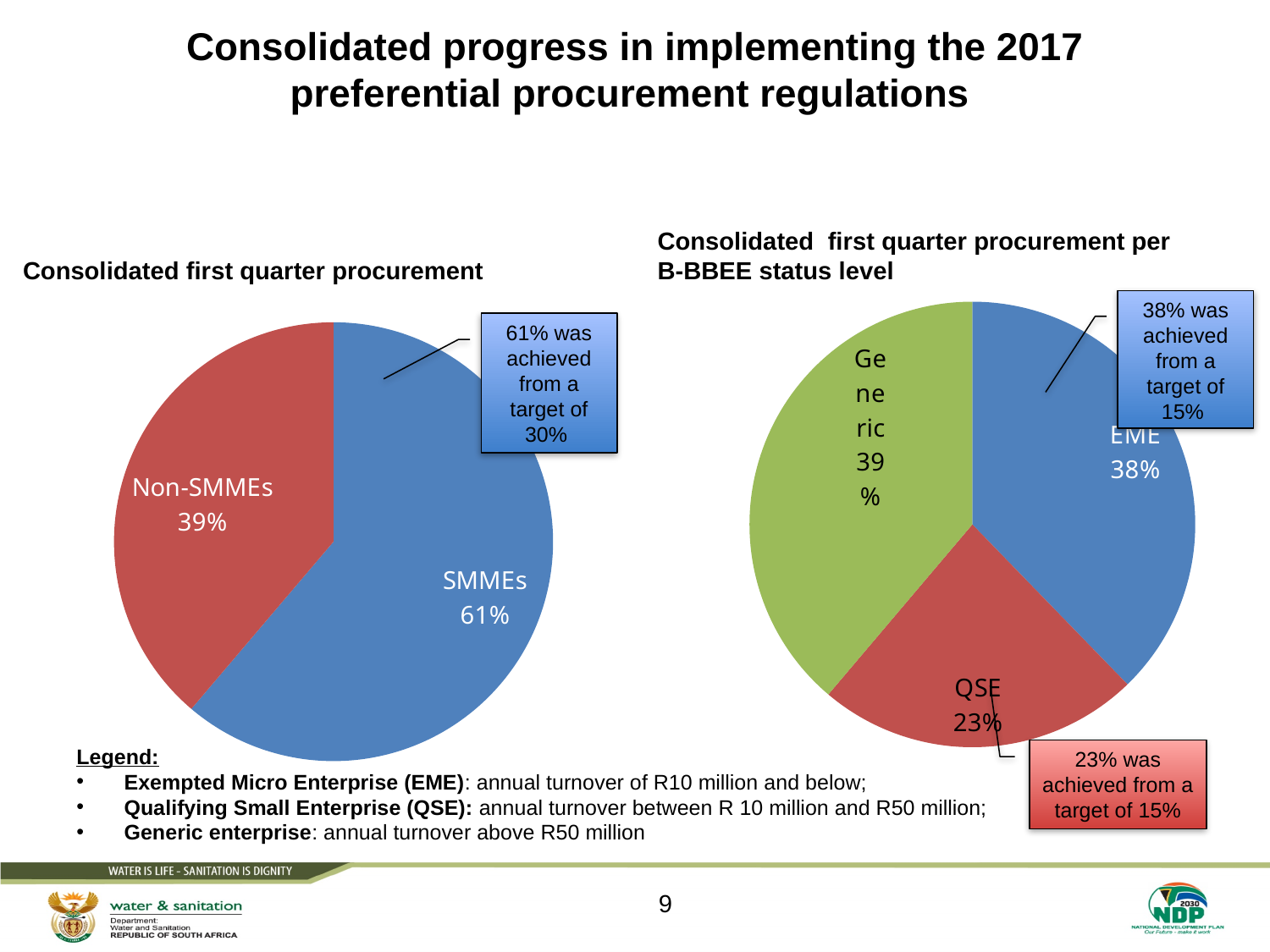
How many slices does the 'Consolidated first quarter procurement' pie chart have? 2 In the 'Consolidated first quarter procurement per B-BBEE status level' chart, which is larger, the EME share or the QSE share? EME In the 'Consolidated first quarter procurement per B-BBEE status level' chart, what share is shown for QSE? 23% In the 'Consolidated first quarter procurement' chart, what share of procurement went to Non-SMMEs? 39% In the 'Consolidated first quarter procurement per B-BBEE status level' chart, what share is shown for EME? 38% In the 'Consolidated first quarter procurement per B-BBEE status level' chart, what share is shown for Generic? 39% How many categories are shown in the 'Consolidated first quarter procurement per B-BBEE status level' pie chart? 3 In the 'Consolidated first quarter procurement' chart, what share of procurement went to SMMEs? 61% In the 'Consolidated first quarter procurement' chart, what is the difference in percentage points between the SMMEs and Non-SMMEs shares? 22 percentage points In the 'Consolidated first quarter procurement' chart, which category has the larger share? SMMEs In the 'Consolidated first quarter procurement per B-BBEE status level' chart, which category has the smallest share? QSE What type of chart is the 'Consolidated first quarter procurement' chart? Pie chart